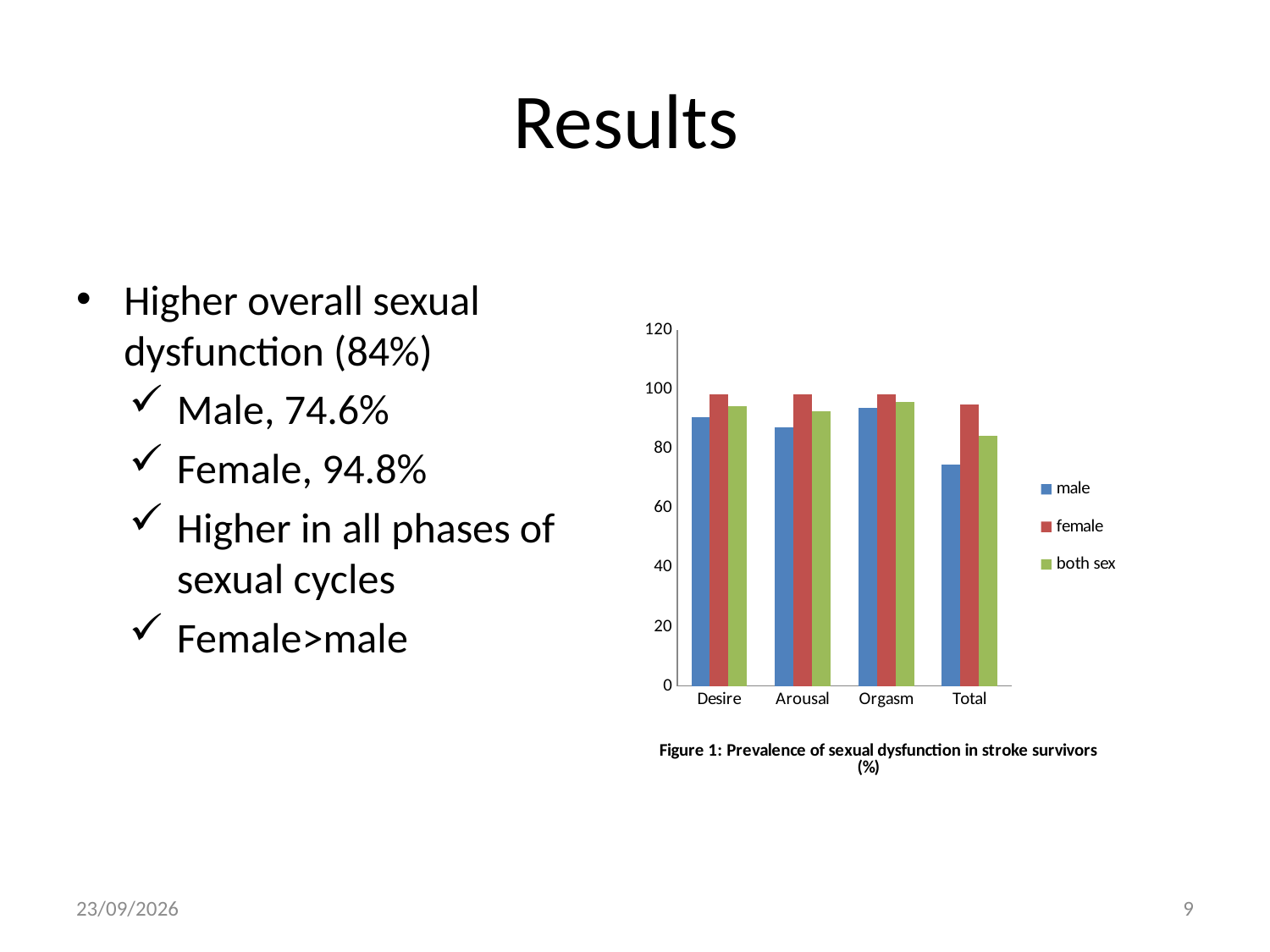
How many series does the chart's legend list? 3 What kind of chart is shown on the slide? bar chart For which category is the male value lowest? Total Is the male value for Arousal greater or less than 80? greater For which category is the both sex value lowest? Total In the Total category, which is larger, the male value or the female value? female In the Total category, which is larger, the male value or the both sex value? both sex How many categories are shown on the x axis of the chart? 4 What is the title of the figure shown on the slide? Figure 1: Prevalence of sexual dysfunction in stroke survivors (%) What are the series names listed in the chart's legend? male, female, both sex Is the female value for Desire greater or less than 80? greater Is the male value for Total greater or less than 80? less